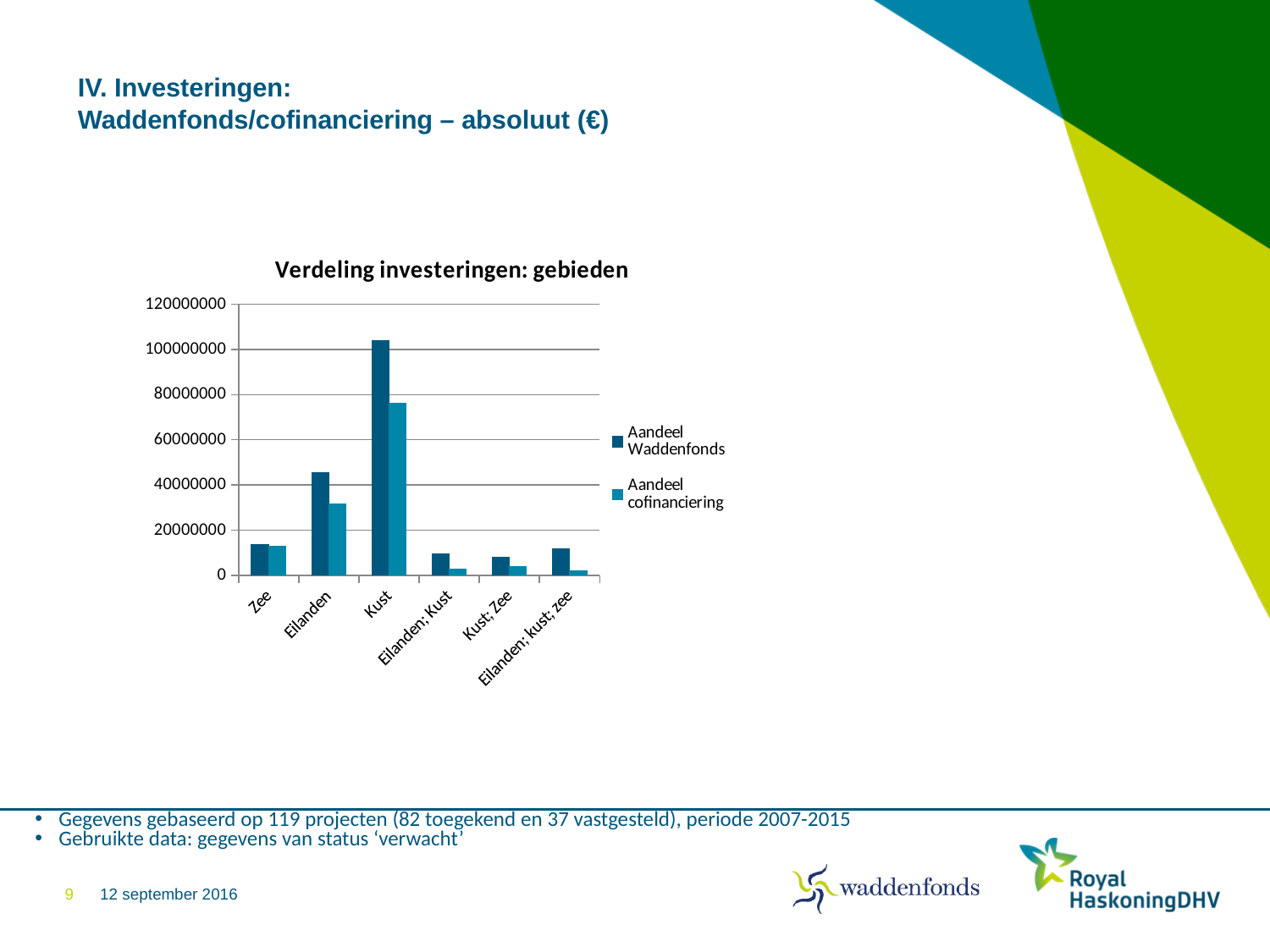
Which category has the highest value for Aandeel cofinanciering? Kust Is the Aandeel Waddenfonds value for Eilanden greater or less than 40000000? greater Which category has the highest value for Aandeel Waddenfonds? Kust Is the Aandeel Waddenfonds value for Kust greater or less than 100000000? greater How many categories are shown on the x axis? 6 Which series is shown in the lighter blue colour in the legend? Aandeel cofinanciering Is the Aandeel cofinanciering value for Eilanden greater or less than 40000000? less What kind of chart is shown on the slide? bar chart What is the title of the chart? Verdeling investeringen: gebieden For Kust, which is larger: Aandeel Waddenfonds or Aandeel cofinanciering? Aandeel Waddenfonds How many series does the legend list? 2